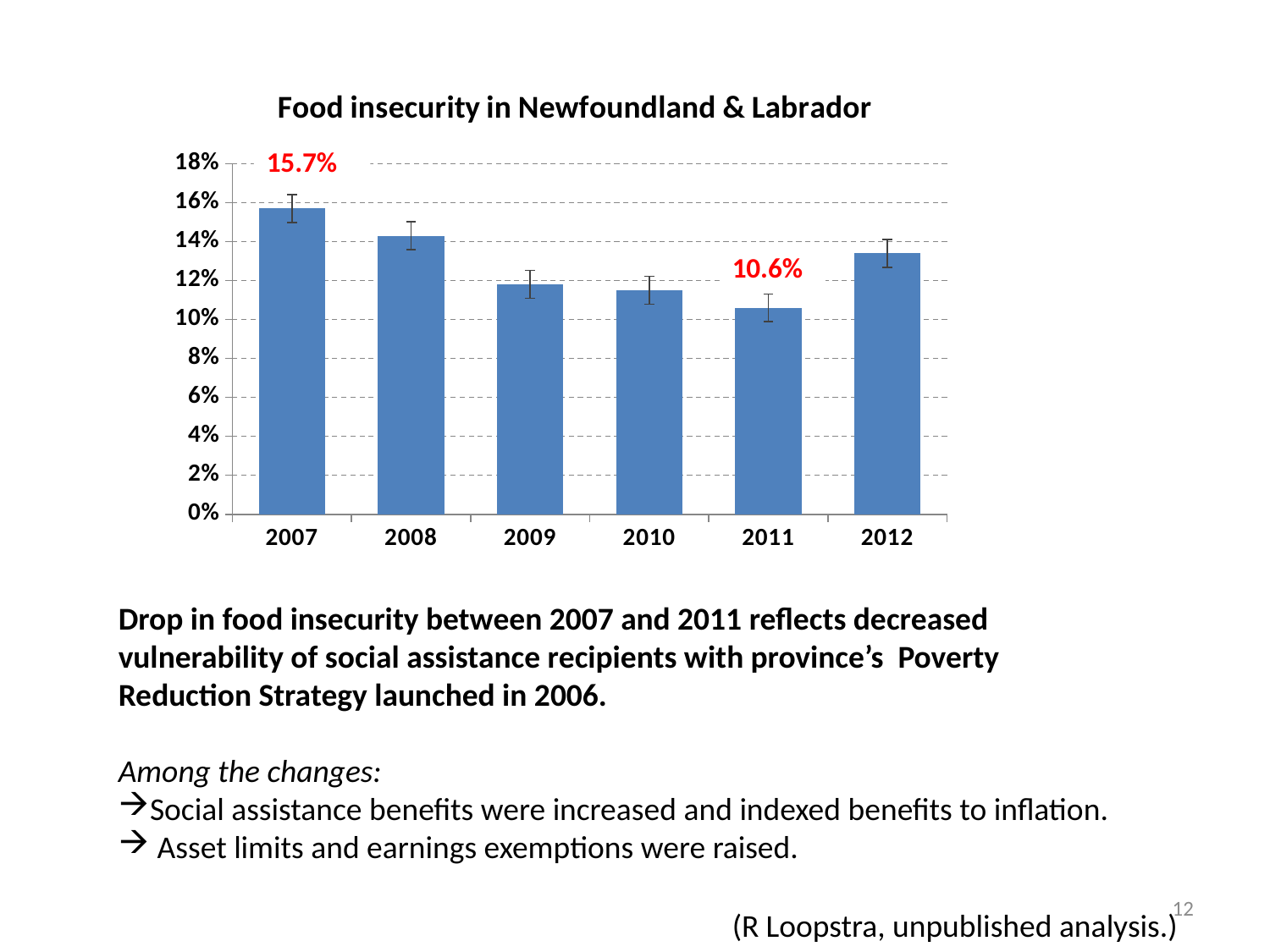
Is the value for 2010 greater or less than 10%? greater What kind of chart is shown on the slide? Bar chart Does food insecurity rise or fall from 2007 to 2011? Fall What is the food insecurity rate shown for 2011? 10.6% Which year has the lowest food insecurity rate? 2011 Which year has a higher food insecurity rate, 2008 or 2009? 2008 Is the value for 2008 greater or less than 16%? less What is the food insecurity rate shown for 2007? 15.7% By how many percentage points did food insecurity fall from 2007 to 2011? 5.1 percentage points Which year has the highest food insecurity rate? 2007 How many years are shown on the x axis of the chart? 6 Is the value for 2012 greater or less than 12%? greater